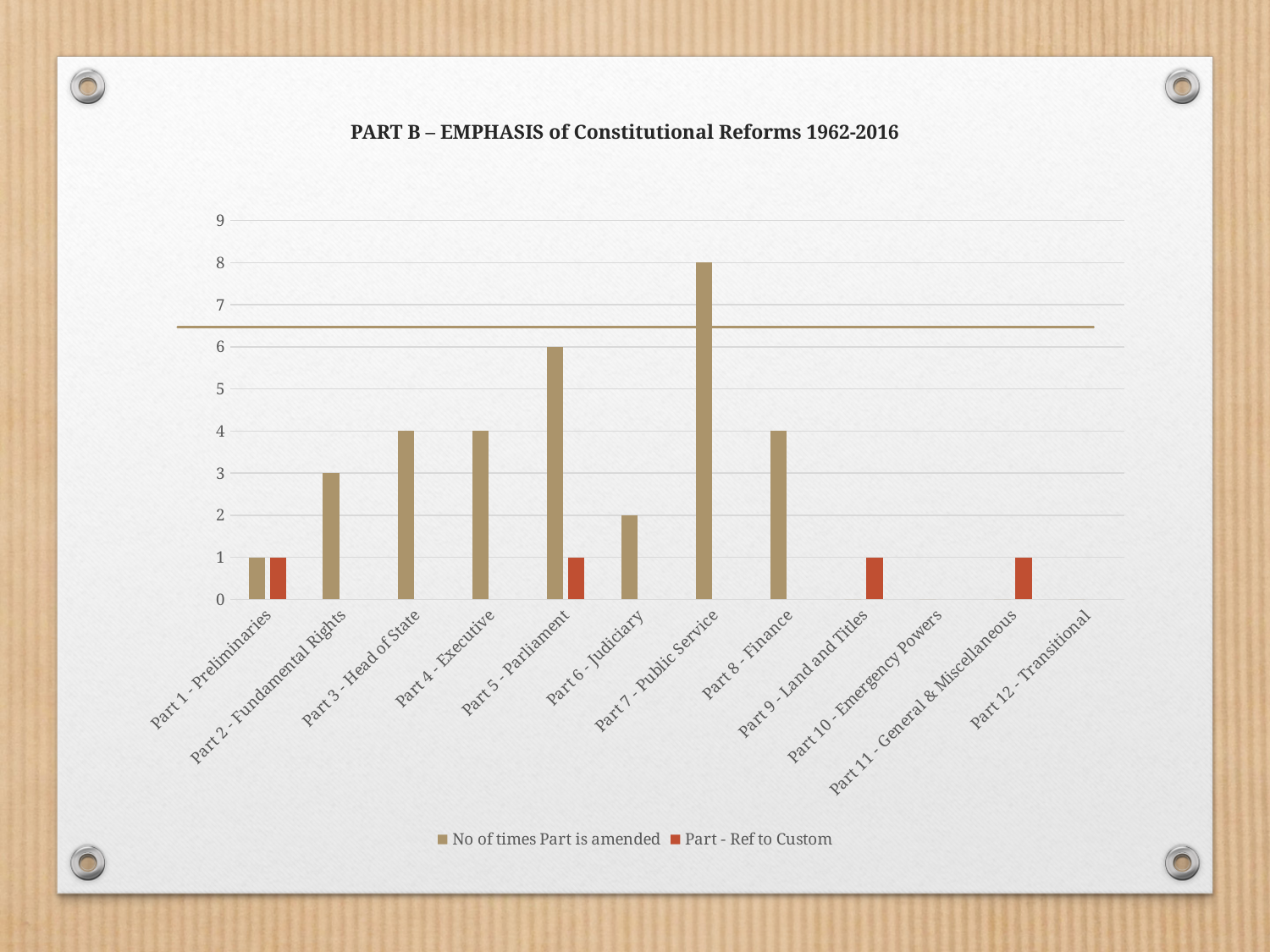
Which was amended more times, Part 6 - Judiciary or Part 8 - Finance? Part 8 - Finance What is the number of times Part 5 - Parliament was amended? 6 What is the value of the 'Part - Ref to Custom' series for Part 9 - Land and Titles? 1 What is the number of times Part 2 - Fundamental Rights was amended? 3 Which Part has the highest number of times amended? Part 7 - Public Service How many categories (Parts) are shown on the x axis? 12 What type of chart is shown on the slide? Bar chart What is the number of times Part 7 - Public Service was amended? 8 Is the number of times Part 7 - Public Service was amended greater or less than 7? greater What is the title of the chart? PART B – EMPHASIS of Constitutional Reforms 1962-2016 What is the difference between the number of times Part 7 - Public Service and Part 5 - Parliament were amended? 2 How many series does the legend list? 2